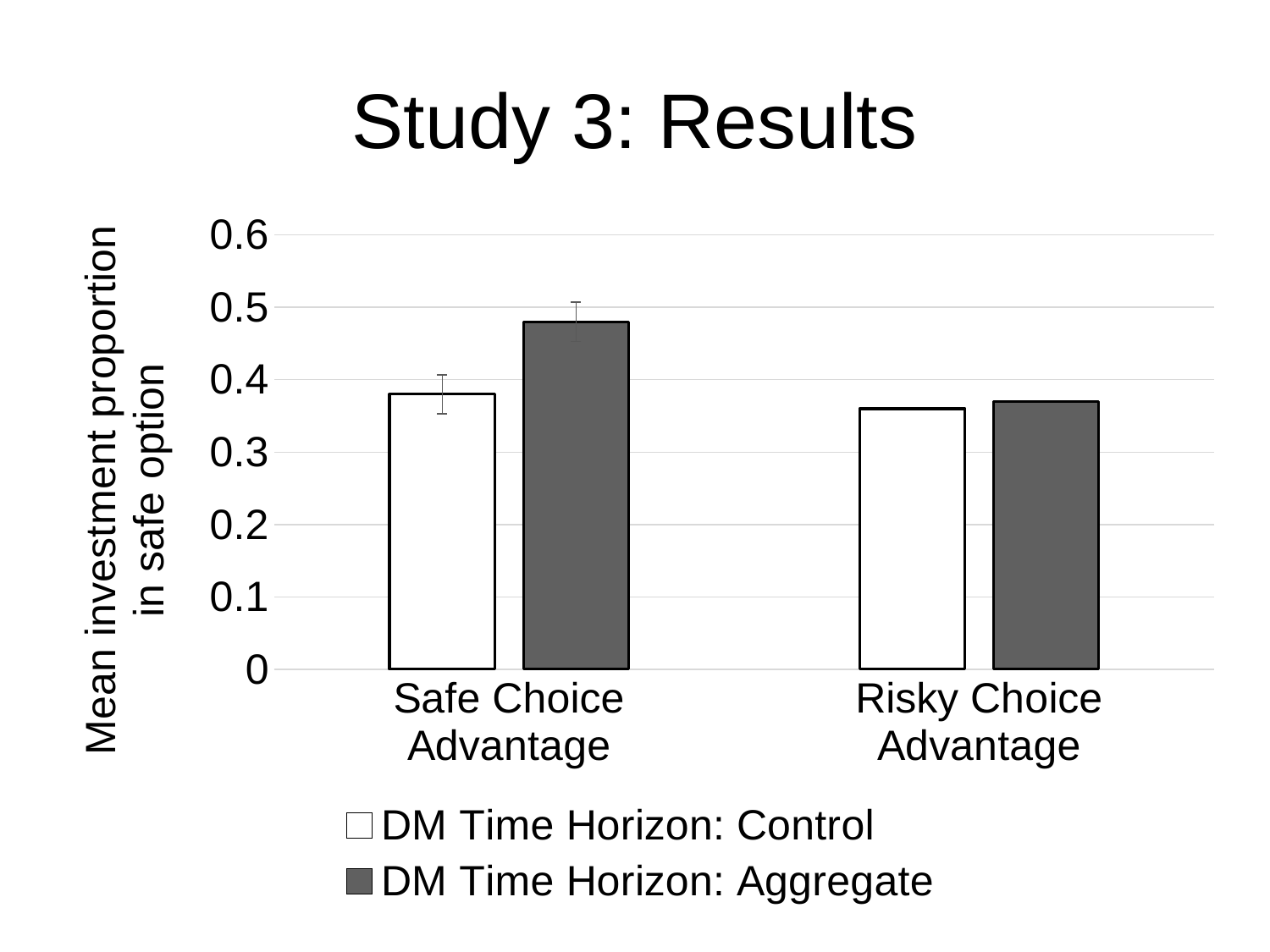
How many series does the legend list? 2 What is the title of the slide containing the chart? Study 3: Results What kind of chart is shown on the slide? bar chart How many categories are shown on the x axis? 2 What is the label of the y axis? Mean investment proportion in safe option Which bar is the highest in the chart? DM Time Horizon: Aggregate for Safe Choice Advantage Is the value for DM Time Horizon: Aggregate under Risky Choice Advantage greater or less than 0.4? less Is the value for DM Time Horizon: Aggregate under Safe Choice Advantage greater or less than 0.4? greater Is the value for DM Time Horizon: Control under Risky Choice Advantage greater or less than 0.3? greater For DM Time Horizon: Aggregate, which category has the larger value: Safe Choice Advantage or Risky Choice Advantage? Safe Choice Advantage For Safe Choice Advantage, which is larger: DM Time Horizon: Control or DM Time Horizon: Aggregate? DM Time Horizon: Aggregate